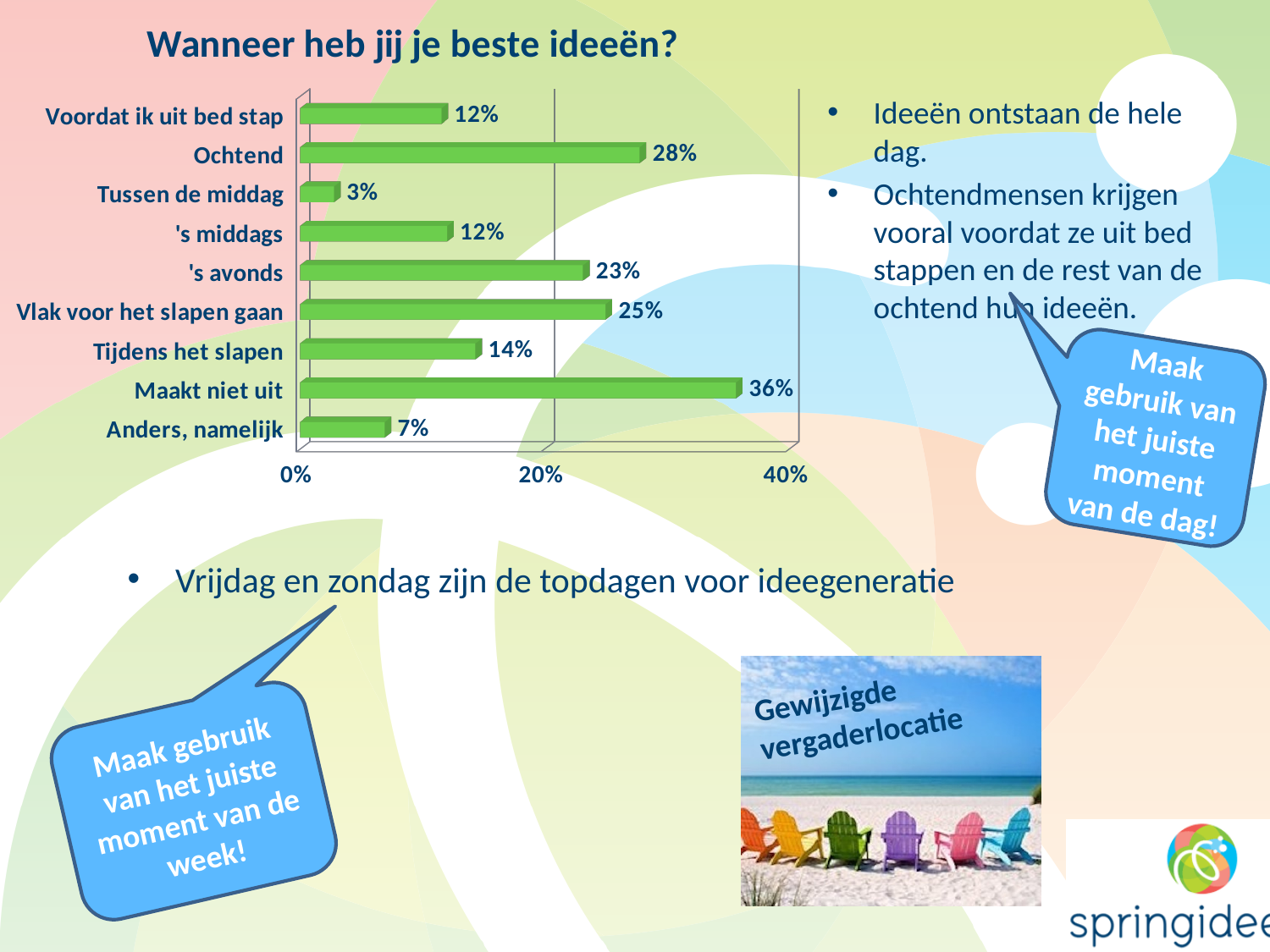
Is the value for 'Maakt niet uit' greater or less than 20%? greater What is the title of the chart? Wanneer heb jij je beste ideeën? Which category has the lowest value? Tussen de middag What kind of chart is shown on the slide? bar chart What is the value for 'Vlak voor het slapen gaan'? 25% What is the difference between the values for 'Maakt niet uit' and 'Ochtend'? 8% What is the value for 'Tijdens het slapen'? 14% What is the value for 'Ochtend'? 28% What colour are the bars in the chart? green Which is larger, the value for ''s avonds' or the value for 'Tijdens het slapen'? 's avonds Which category has the highest value? Maakt niet uit How many categories are shown in the chart? 9